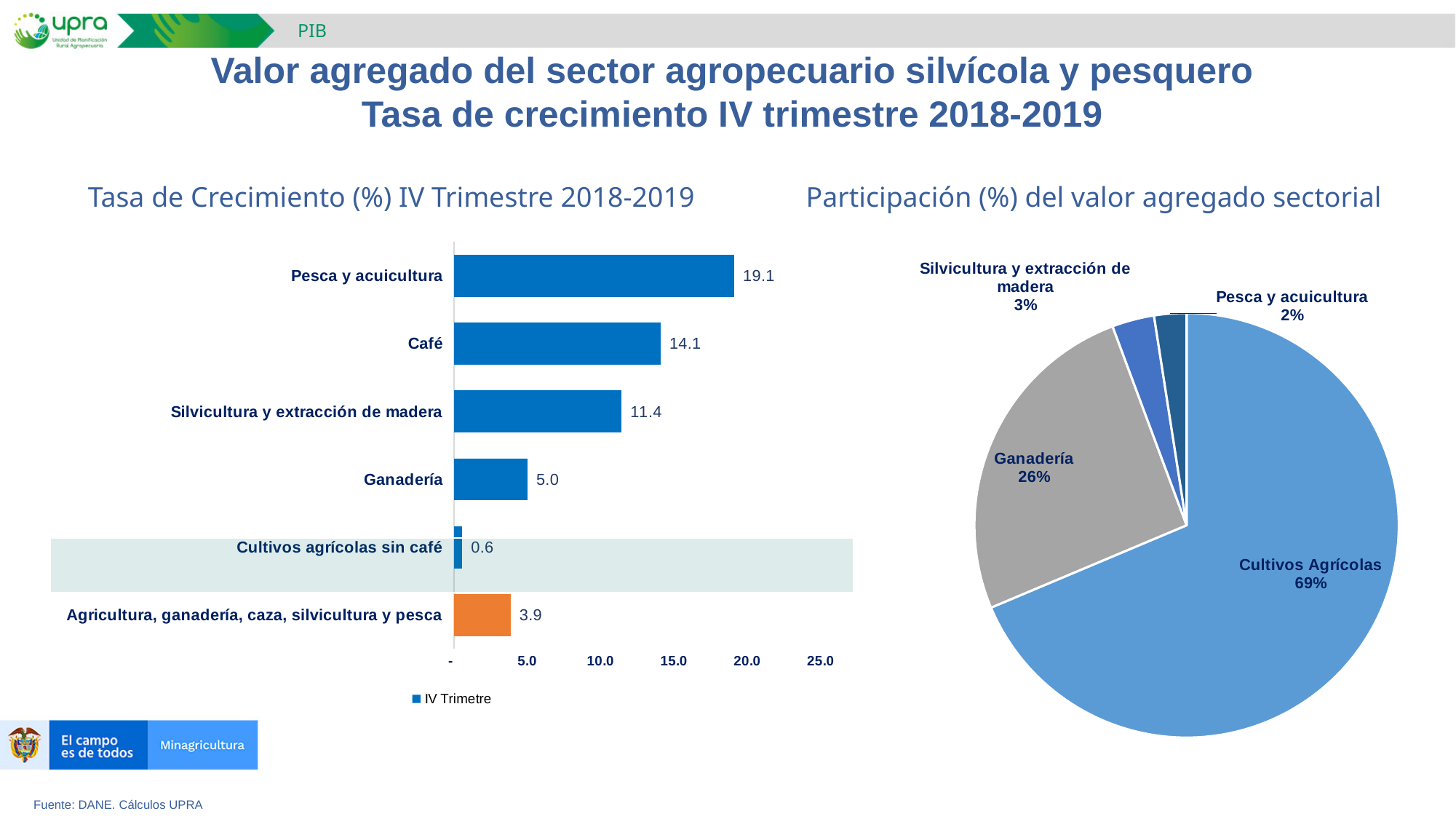
In the 'Tasa de Crecimiento (%) IV Trimestre 2018-2019' chart, which category has the highest value? Pesca y acuicultura In the 'Participación (%) del valor agregado sectorial' pie chart, what share does Ganadería have? 26% In the 'Tasa de Crecimiento (%) IV Trimestre 2018-2019' chart, how many categories are shown? 6 In the 'Tasa de Crecimiento (%) IV Trimestre 2018-2019' chart, what is the value for Café? 14.1 In the 'Tasa de Crecimiento (%) IV Trimestre 2018-2019' chart, which is larger: Silvicultura y extracción de madera or Agricultura, ganadería, caza, silvicultura y pesca? Silvicultura y extracción de madera In the 'Tasa de Crecimiento (%) IV Trimestre 2018-2019' chart, what series name does the legend show? IV Trimetre What kind of chart is the 'Tasa de Crecimiento (%) IV Trimestre 2018-2019' chart? Bar chart In the 'Participación (%) del valor agregado sectorial' pie chart, which slice is the largest? Cultivos Agrícolas In the 'Tasa de Crecimiento (%) IV Trimestre 2018-2019' chart, what is the value for Ganadería? 5.0 In the 'Tasa de Crecimiento (%) IV Trimestre 2018-2019' chart, what is the difference between Pesca y acuicultura and Café? 5.0 In the 'Tasa de Crecimiento (%) IV Trimestre 2018-2019' chart, which category has the lowest value? Cultivos agrícolas sin café In the 'Participación (%) del valor agregado sectorial' pie chart, how many slices are there? 4